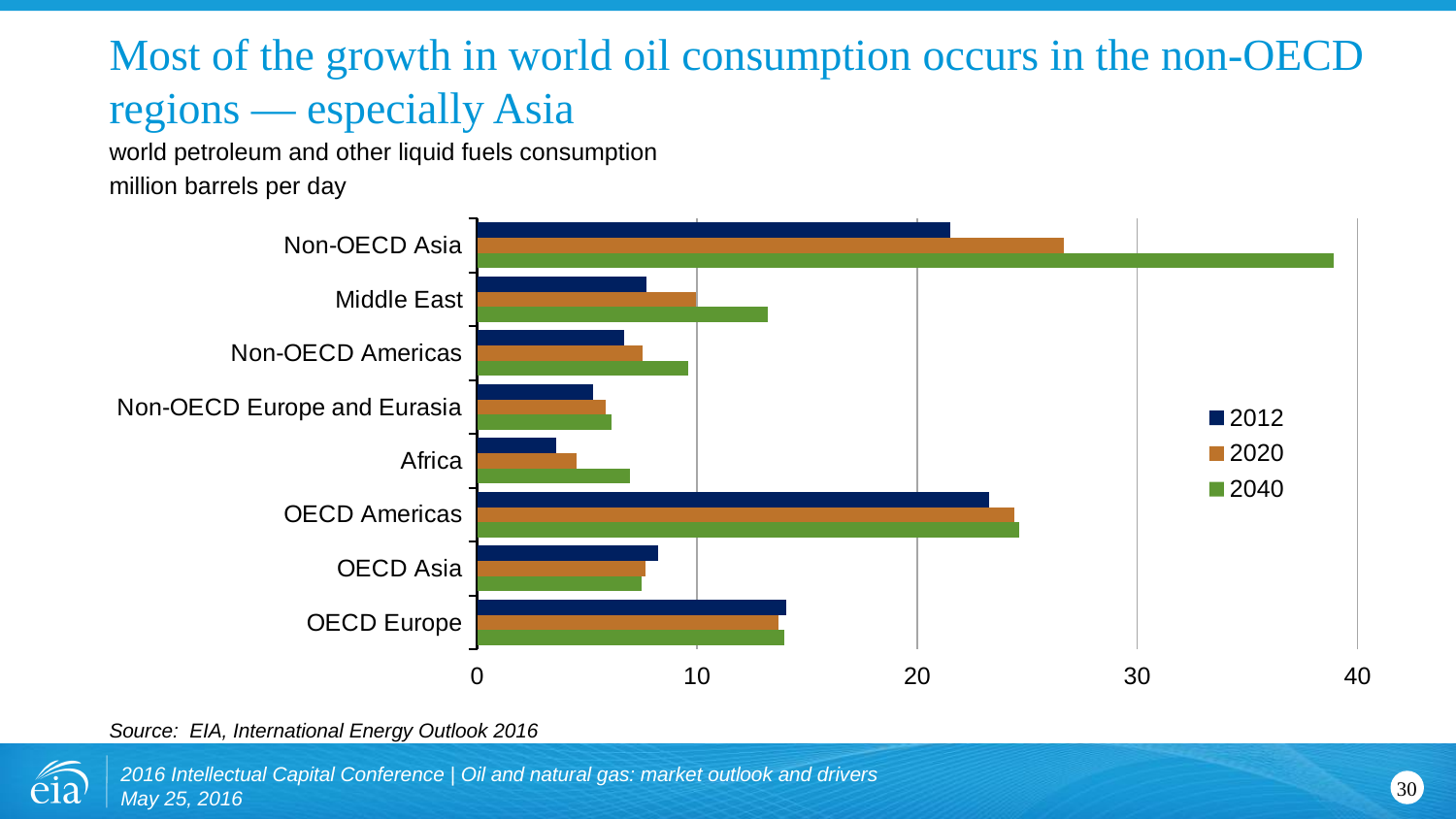
Which region has the highest value for 2012? OECD Americas Is the 2040 value for Middle East greater or less than 10? greater Which region has the lowest value for 2012? Africa Is the 2012 value for OECD Europe greater or less than 10? greater Which region has the highest value for 2040? Non-OECD Asia How many series does the legend list? 3 Which is larger for 2040: Middle East or Non-OECD Americas? Middle East Is the 2040 value for Non-OECD Asia greater or less than 30? greater What kind of chart is shown on the slide? bar chart What unit is the chart measured in? million barrels per day How many regions are listed on the chart? 8 Does the value for Non-OECD Asia rise or fall from 2012 to 2040? rise